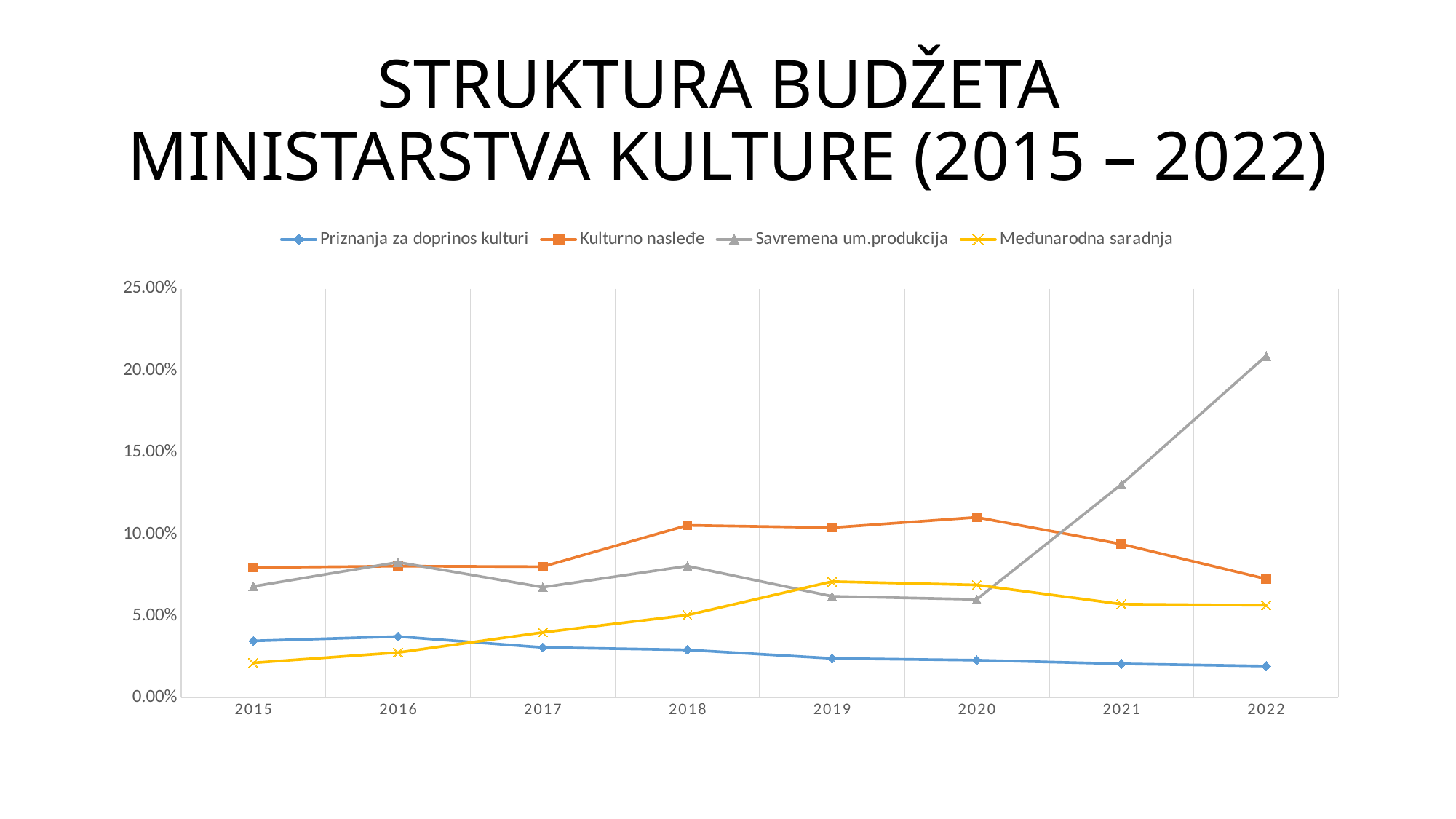
What is the title of the slide? STRUKTURA BUDŽETA MINISTARSTVA KULTURE (2015 – 2022) Which series has the highest value in 2022? Savremena um.produkcija What kind of chart is shown on the slide? line chart Is the value for Savremena um.produkcija in 2022 greater or less than 15.00%? greater How many years are shown on the x axis? 8 Is the value for Kulturno nasleđe in 2020 greater or less than 10.00%? greater Is the value for Priznanja za doprinos kulturi in 2022 greater or less than 5.00%? less Which series has the lowest value in 2015? Međunarodna saradnja Does the Priznanja za doprinos kulturi line rise or fall from 2016 to 2022? fall In 2019, which is larger: Međunarodna saradnja or Savremena um.produkcija? Međunarodna saradnja How many series does the legend list? 4 In which year does Kulturno nasleđe reach its highest value? 2020